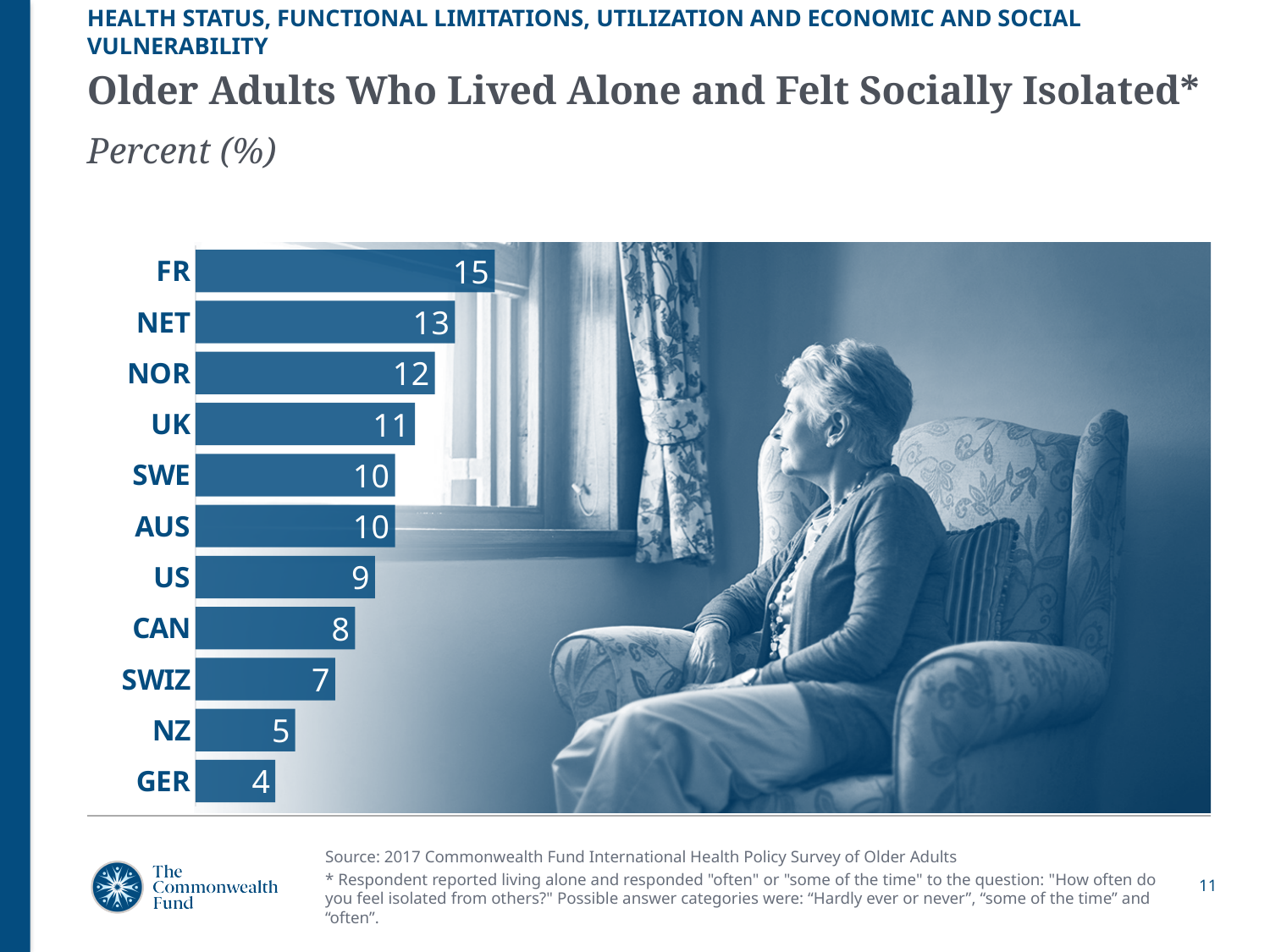
What is the difference between the values for NET and CAN? 5 What kind of chart is shown on the slide? Bar chart Which country has the lowest value? GER What is the difference between the values for FR and GER? 11 What is the value for FR? 15 How many countries are shown in the chart? 11 Which country has the highest value? FR Which is larger, the value for NOR or the value for SWIZ? NOR What is the value for NZ? 5 What is the title of the chart? Older Adults Who Lived Alone and Felt Socially Isolated* What is the value for US? 9 What is the value for GER? 4